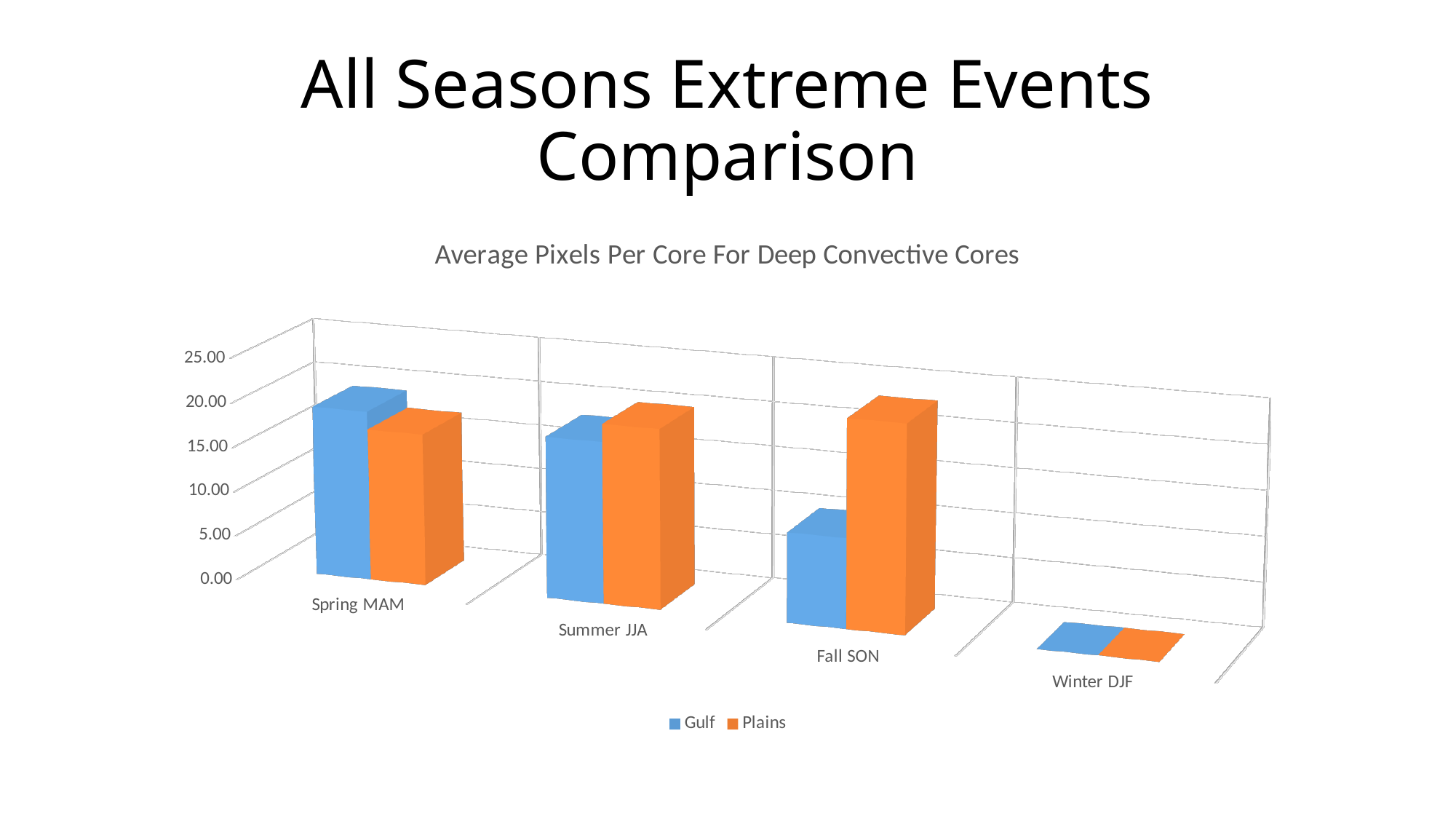
What is the title of the chart? Average Pixels Per Core For Deep Convective Cores For which season is the Gulf value lowest? Winter DJF How many seasons (categories) are shown on the x axis? 4 For which season is the Plains value lowest? Winter DJF How many series does the legend list? 2 Which is larger, the Gulf value for Spring MAM or the Gulf value for Fall SON? Spring MAM Is the Plains value for Fall SON greater or less than 15.00? greater Which colour represents the Plains series? orange In Fall SON, which series has the larger value, Gulf or Plains? Plains Is the Gulf value for Winter DJF greater or less than 5.00? less For which season is the Plains value highest? Fall SON What kind of chart is shown on the slide? bar chart